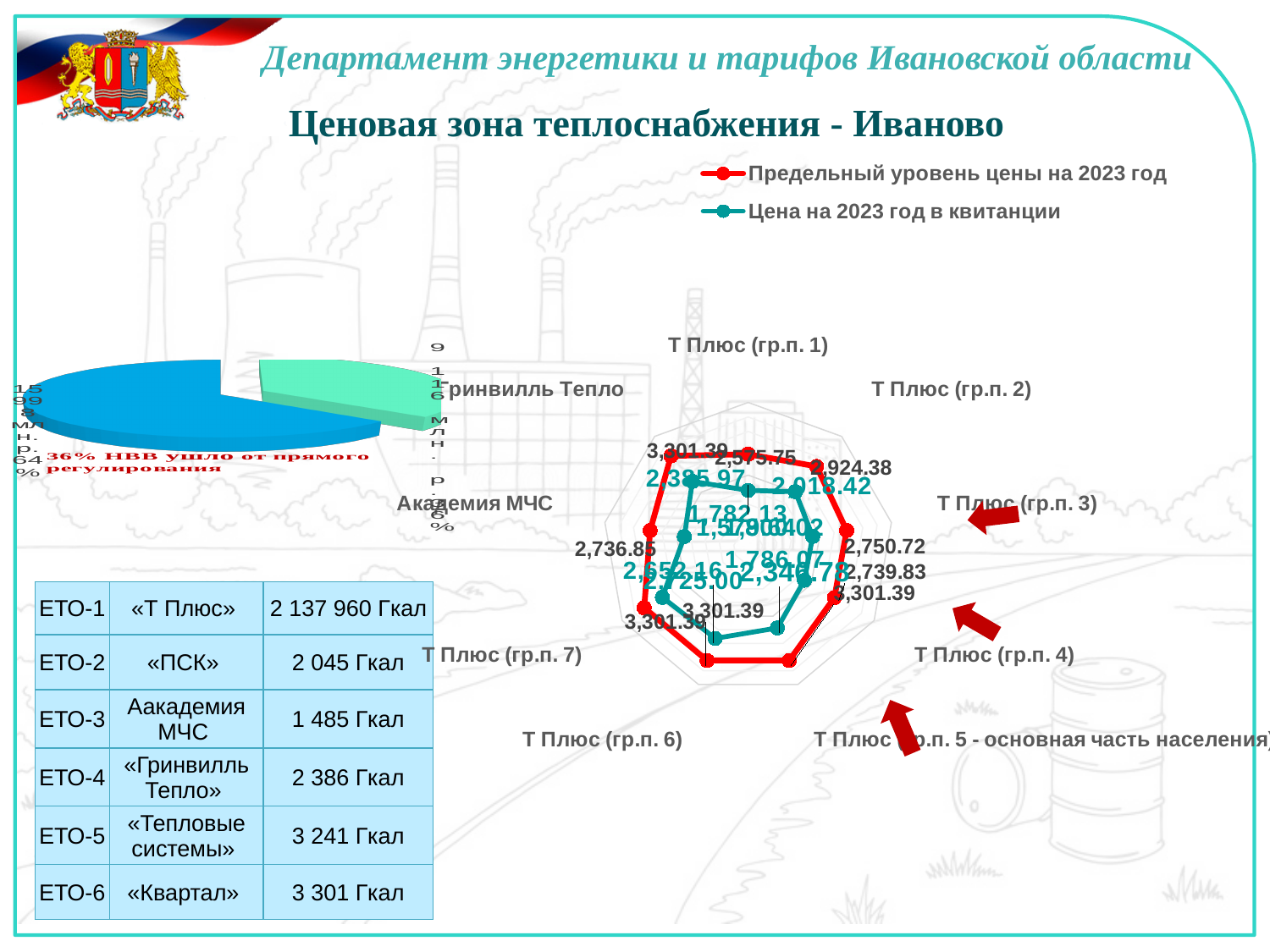
On the radar chart, which category has the lowest value for 'Предельный уровень цены на 2023 год'? Т Плюс (гр.п. 1) On the radar chart, what is the value of 'Предельный уровень цены на 2023 год' for Т Плюс (гр.п. 2)? 2,924.38 How many series does the legend of the radar chart list? 2 On the radar chart, which is larger for Т Плюс (гр.п. 2): 'Предельный уровень цены на 2023 год' or 'Цена на 2023 год в квитанции'? Предельный уровень цены на 2023 год What kind of chart is the large chart on the right of the slide? radar chart On the radar chart, what is the value of 'Предельный уровень цены на 2023 год' for Т Плюс (гр.п. 3)? 2,750.72 On the radar chart, what is the value of 'Предельный уровень цены на 2023 год' for Академия МЧС? 2,736.85 On the radar chart, what is the difference between the 'Предельный уровень цены на 2023 год' values for Т Плюс (гр.п. 2) and Т Плюс (гр.п. 3)? 173.66 On the radar chart, which colour is used for the series 'Цена на 2023 год в квитанции'? teal How many categories are plotted on the radar chart? 9 On the radar chart, what is the value of 'Цена на 2023 год в квитанции' for Т Плюс (гр.п. 2)? 2,018.42 On the radar chart, what is the value of 'Предельный уровень цены на 2023 год' for Гринвилль Тепло? 3,301.39